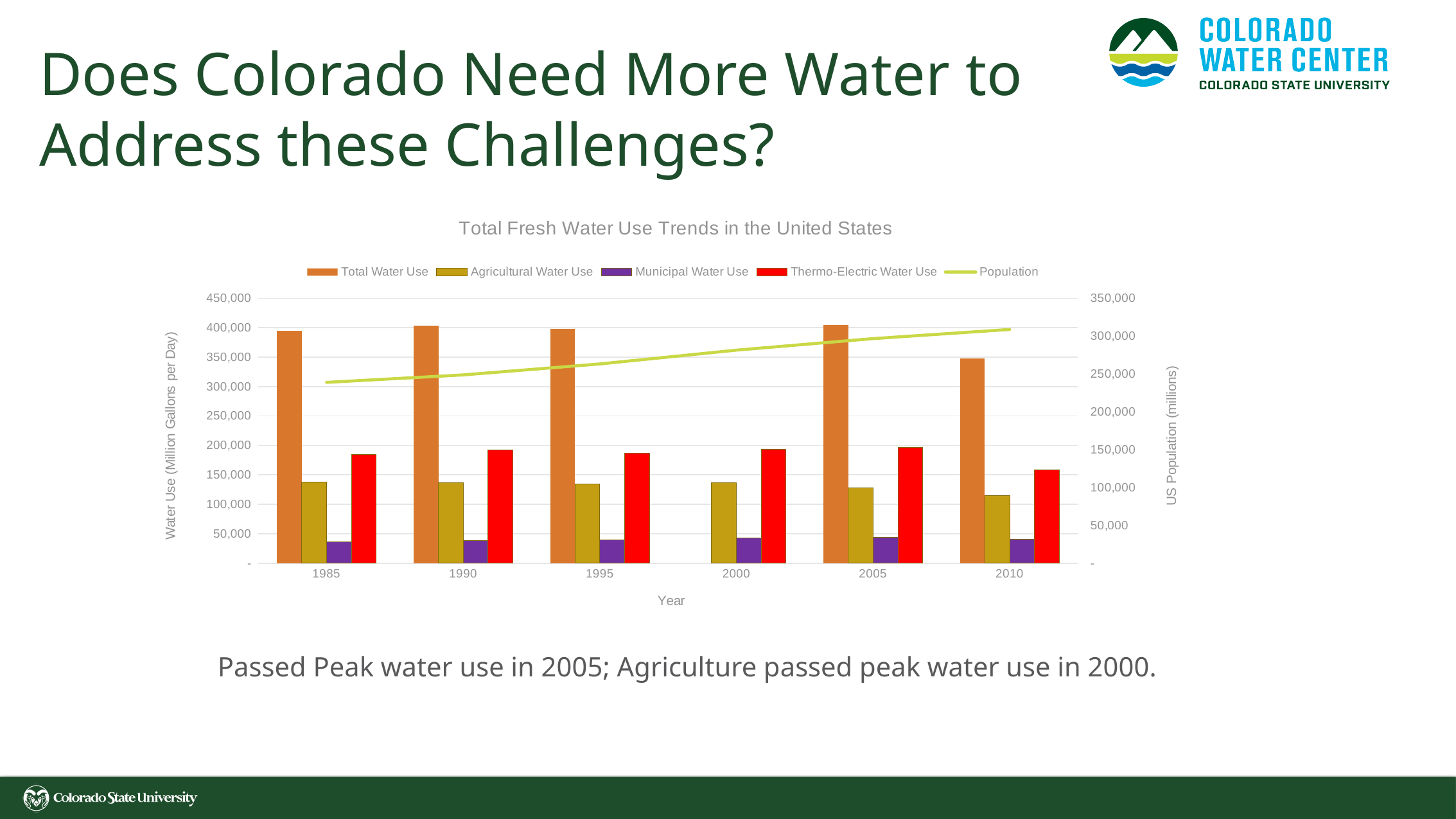
Is the Agricultural Water Use value for 2010 greater or less than 150,000? less Is the Total Water Use value for 1985 greater or less than 350,000? greater How many years are shown on the x axis of the chart? 6 What kind of chart is used to show the water use series? bar chart How many series does the chart legend list? 5 Is the Municipal Water Use value for 1985 greater or less than 50,000? less In 1985, which is larger: Agricultural Water Use or Thermo-Electric Water Use? Thermo-Electric Water Use What is the title of the chart? Total Fresh Water Use Trends in the United States In which year is the Agricultural Water Use bar lowest? 2010 Does the Population line rise or fall from 1985 to 2010? rises In which year is the Thermo-Electric Water Use bar lowest? 2010 In which year is the Total Water Use bar lowest? 2010